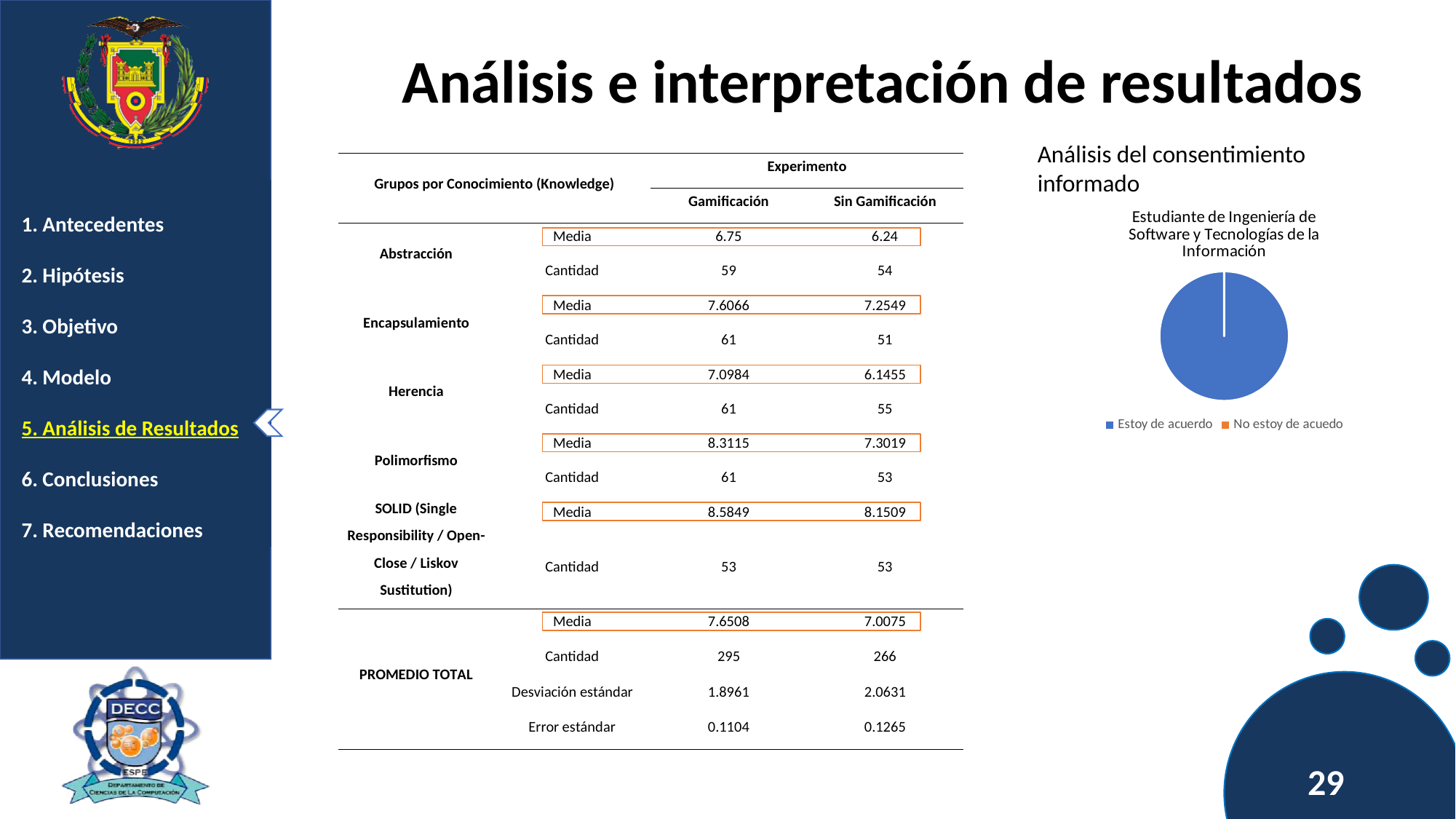
Which category takes up the largest share of the pie chart? Estoy de acuerdo What kind of chart is shown under the heading 'Análisis del consentimiento informado'? pie chart In the pie chart, which is larger: the slice for 'Estoy de acuerdo' or the slice for 'No estoy de acuedo'? Estoy de acuerdo What is the title of the pie chart? Estudiante de Ingeniería de Software y Tecnologías de la Información How many entries does the legend of the pie chart list? 2 Which legend entry of the pie chart is shown in blue? Estoy de acuerdo